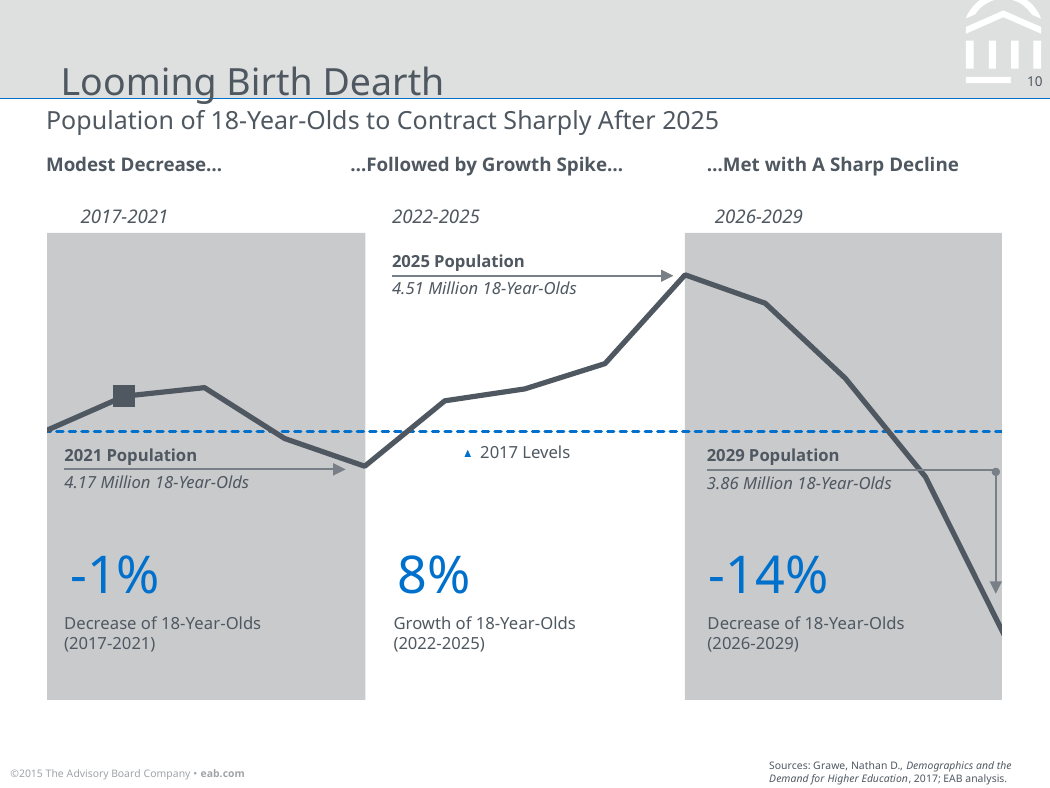
What does the blue dashed horizontal line on the chart represent? 2017 Levels Does the population of 18-year-olds rise or fall after 2025? Fall What is the 2021 population of 18-year-olds shown on the chart? 4.17 Million 18-Year-Olds What is the 2029 population of 18-year-olds shown on the chart? 3.86 Million 18-Year-Olds Of the three labeled years (2021, 2025, 2029), which has the lowest population of 18-year-olds? 2029 What is the difference between the 2025 and 2029 populations of 18-year-olds? 0.65 Million What percentage decrease in 18-year-olds is shown for 2026-2029? -14% What is the 2025 population of 18-year-olds shown on the chart? 4.51 Million 18-Year-Olds Of the three labeled years (2021, 2025, 2029), which has the highest population of 18-year-olds? 2025 What kind of chart is used to show the population of 18-year-olds? Line chart What percentage change in 18-year-olds is shown for 2017-2021? -1% What percentage growth in 18-year-olds is shown for 2022-2025? 8%